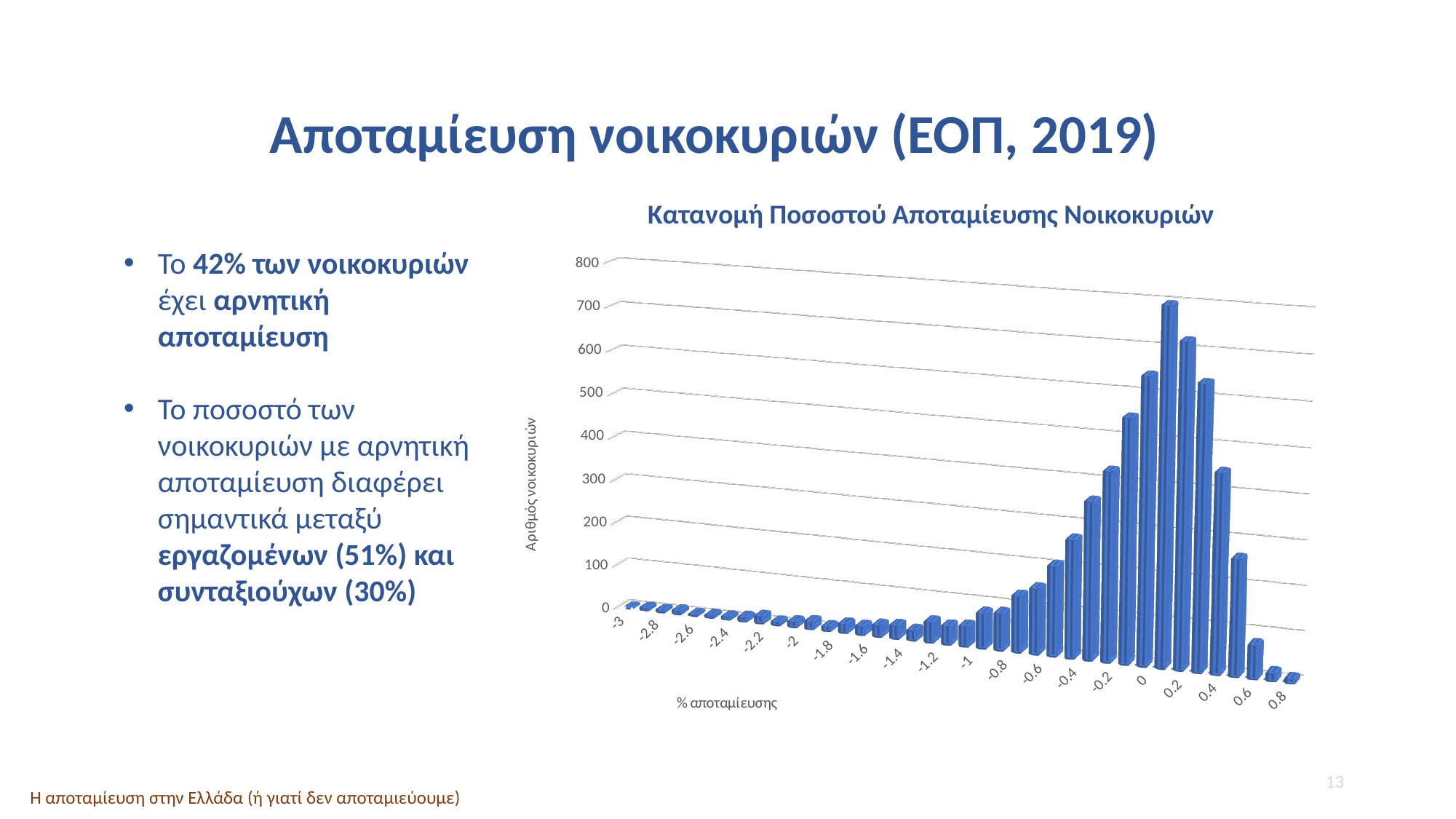
What is the title of the chart? Κατανομή Ποσοστού Αποταμίευσης Νοικοκυριών Do the values rise or fall along the x axis from 0.4 to 0.8? fall What kind of chart is shown on the slide? bar chart Is the value for -3 greater or less than 100? less Is the value of the tallest bar greater or less than 600? greater Which has a larger value, 0.4 or -1? 0.4 Do the values generally rise or fall along the x axis from -1 to 0? rise Which has a larger value, 0.6 or -3? 0.6 What is the label of the vertical axis of the chart? Αριθμός νοικοκυριών How many category labels are shown along the x axis of the chart? 20 Is the value for 0.8 greater or less than 100? less